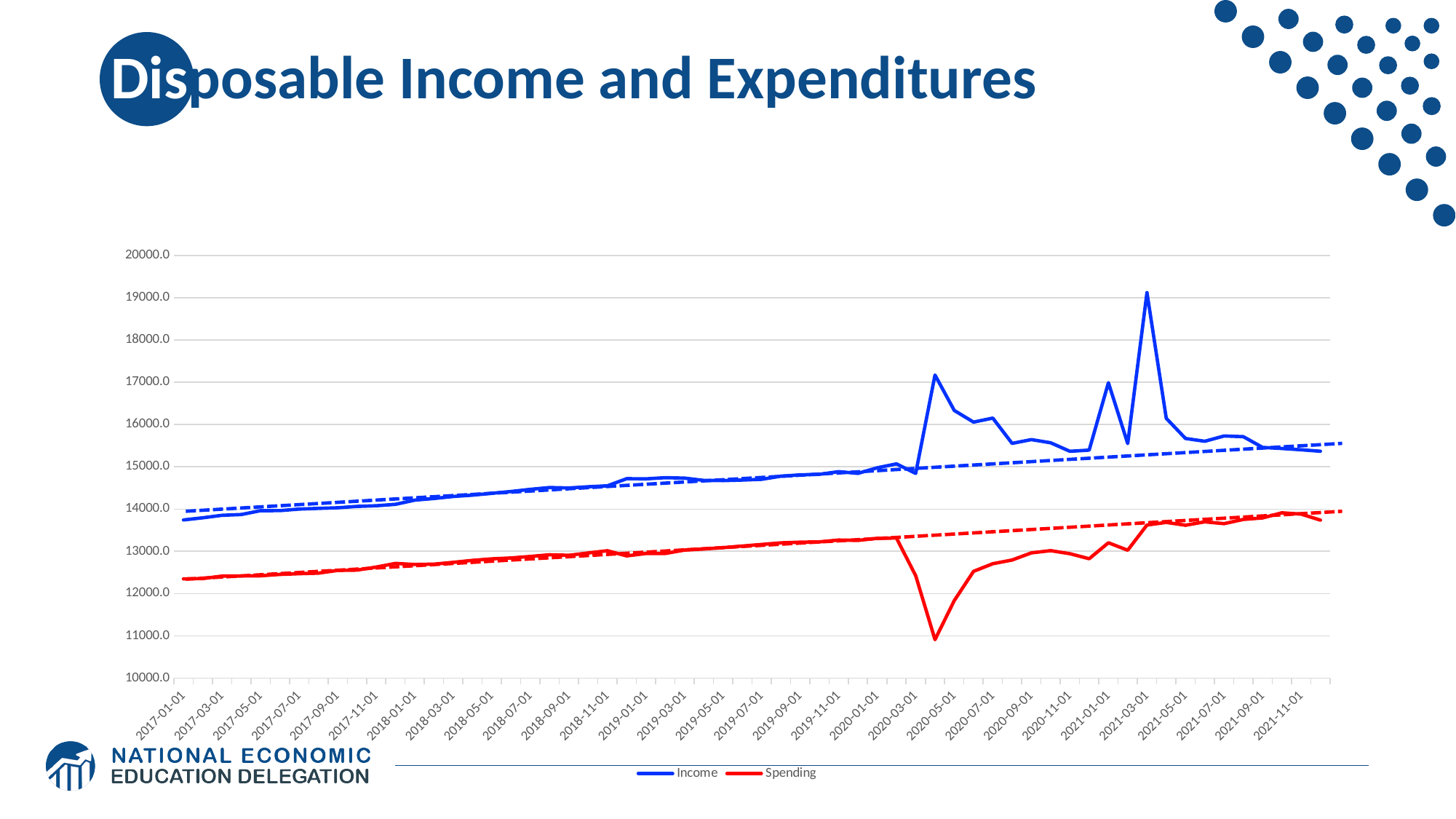
What are the two series named in the legend? Income and Spending Is the lowest Spending value on the chart greater or less than 12000.0? less Which series has the higher values across the whole period, Income or Spending? Income Is the Spending value at 2017-01-01 greater or less than 12000.0? greater What is the highest value shown on the vertical axis? 20000.0 How many series does the legend list? 2 Which series is larger at 2017-01-01, Income or Spending? Income Is the Income value at 2017-01-01 greater or less than 14000.0? less What kind of chart is shown on the slide? Line chart Does the Spending series generally rise or fall from 2017-01-01 to 2021-11-01? Rise What is the title of the slide? Disposable Income and Expenditures